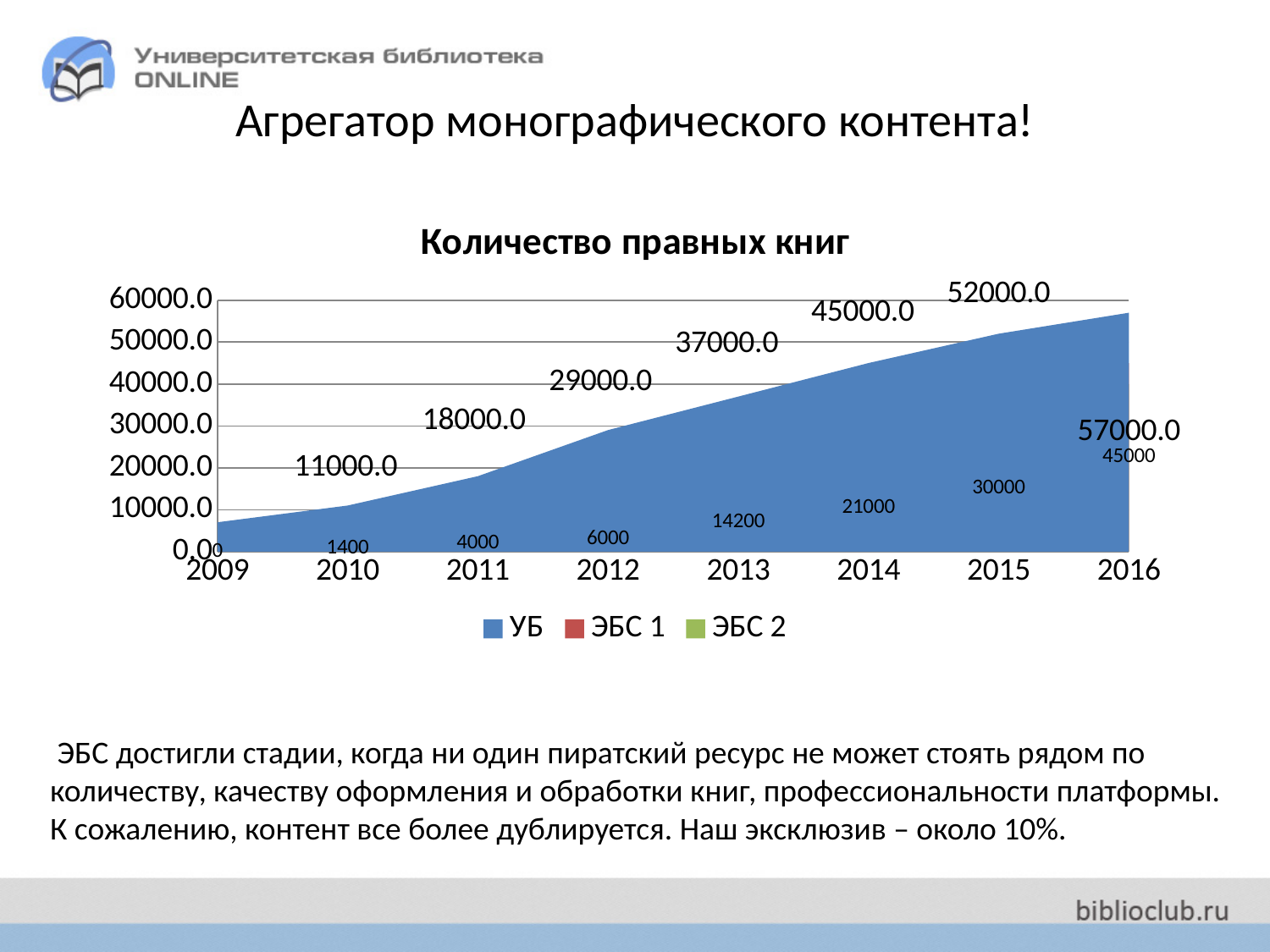
Is the УБ value for 2009 greater or less than 10000.0? less What is the value of УБ for 2013? 37000.0 Which year has the larger УБ value, 2011 or 2012? 2012 How many series does the legend list? 3 What is the title of the chart? Количество правных книг What is the difference between the УБ values for 2015 and 2014? 7000.0 In which year is the УБ value highest? 2016 Do the УБ values rise or fall from 2009 to 2016? rise How many years are shown on the x axis? 8 What is the value of УБ for 2016? 57000.0 What kind of chart is shown? area chart What is the value of УБ for 2010? 11000.0